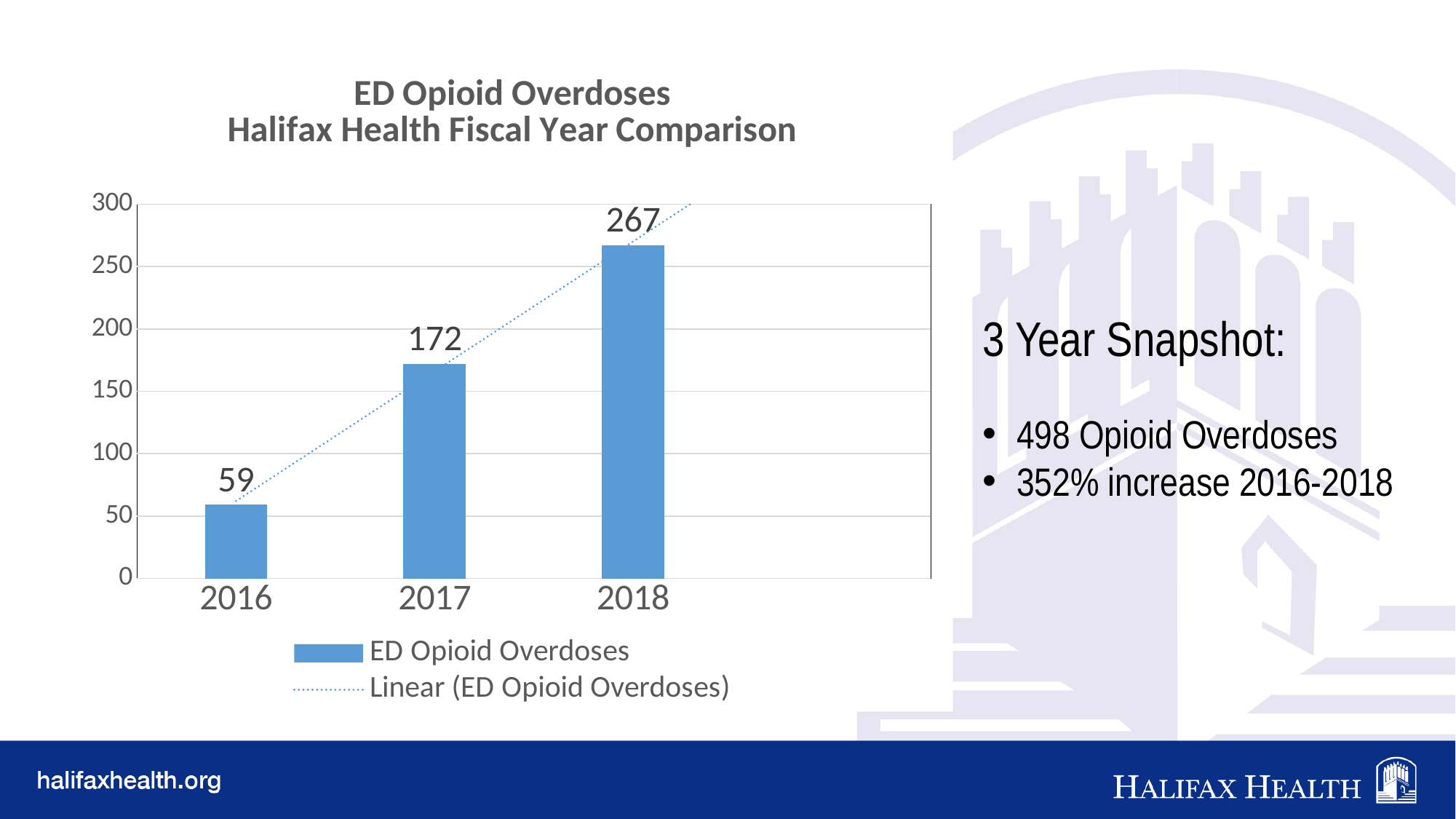
Is the value for 2018 greater or less than 250? greater Do the values rise or fall from 2016 to 2018? rise Which year has the lowest number of ED opioid overdoses? 2016 What is the value for 2016? 59 What is the value for 2017? 172 Which year has the highest number of ED opioid overdoses? 2018 What is the difference between the values for 2018 and 2017? 95 Which is larger, the value for 2017 or the value for 2016? 2017 What is the value for 2018? 267 How many years are shown on the x axis? 3 What kind of chart is this? bar chart What is the difference between the values for 2017 and 2016? 113